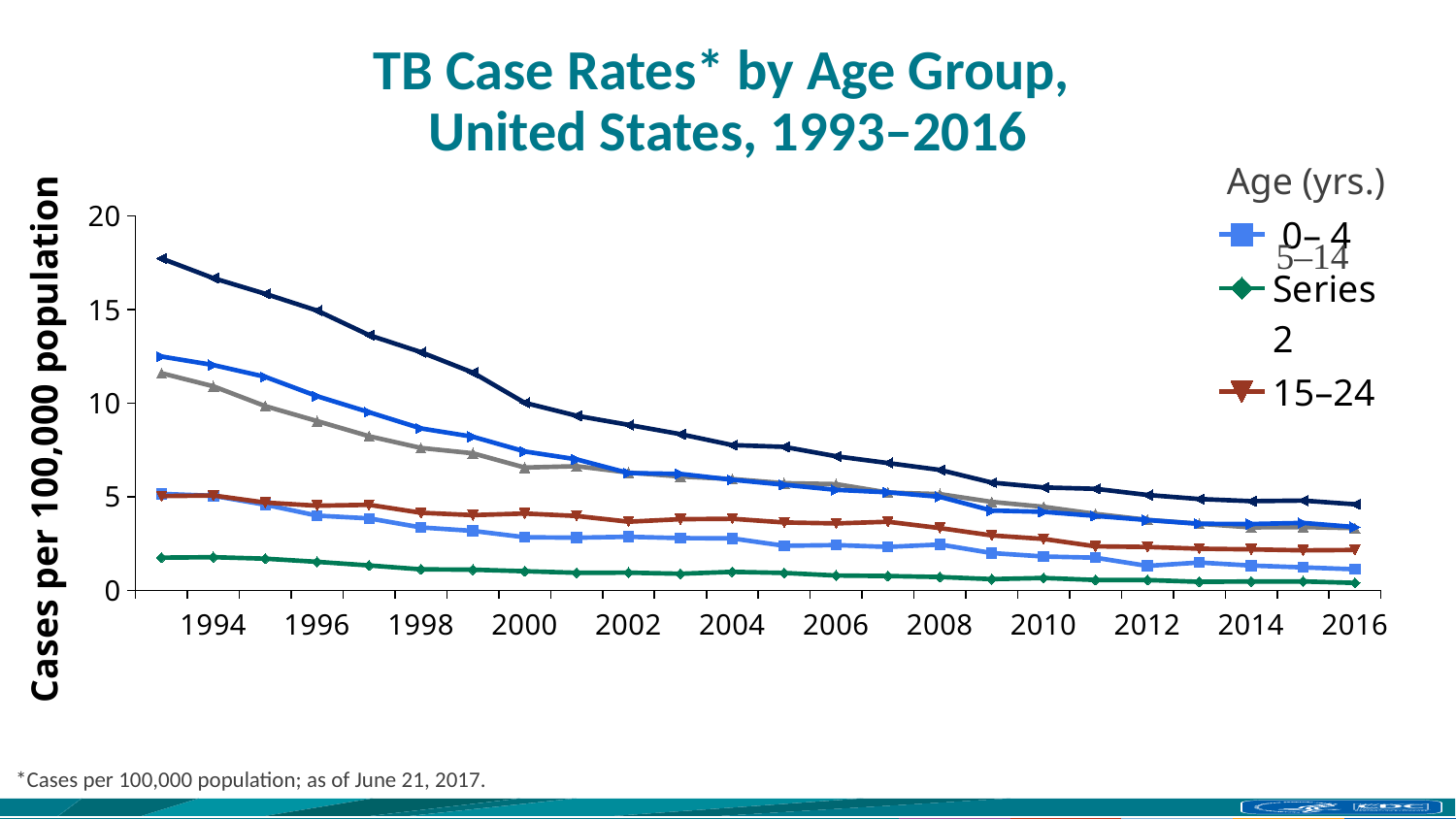
Which legend entry corresponds to the lowest line on the chart? Series 2 Do the case rates generally rise or fall from 1993 to 2016? fall Is the value for the 0–4 age group in 2016 greater or less than 5? less Is the value for the 0–4 age group in 2000 greater or less than 5? less Is the value for the 0–4 age group in 1993 greater or less than 10? less What is the label on the vertical axis? Cases per 100,000 population What is the highest value shown on the vertical axis? 20 What is the title of the chart? TB Case Rates* by Age Group, United States, 1993–2016 What kind of chart is shown on the slide? line chart